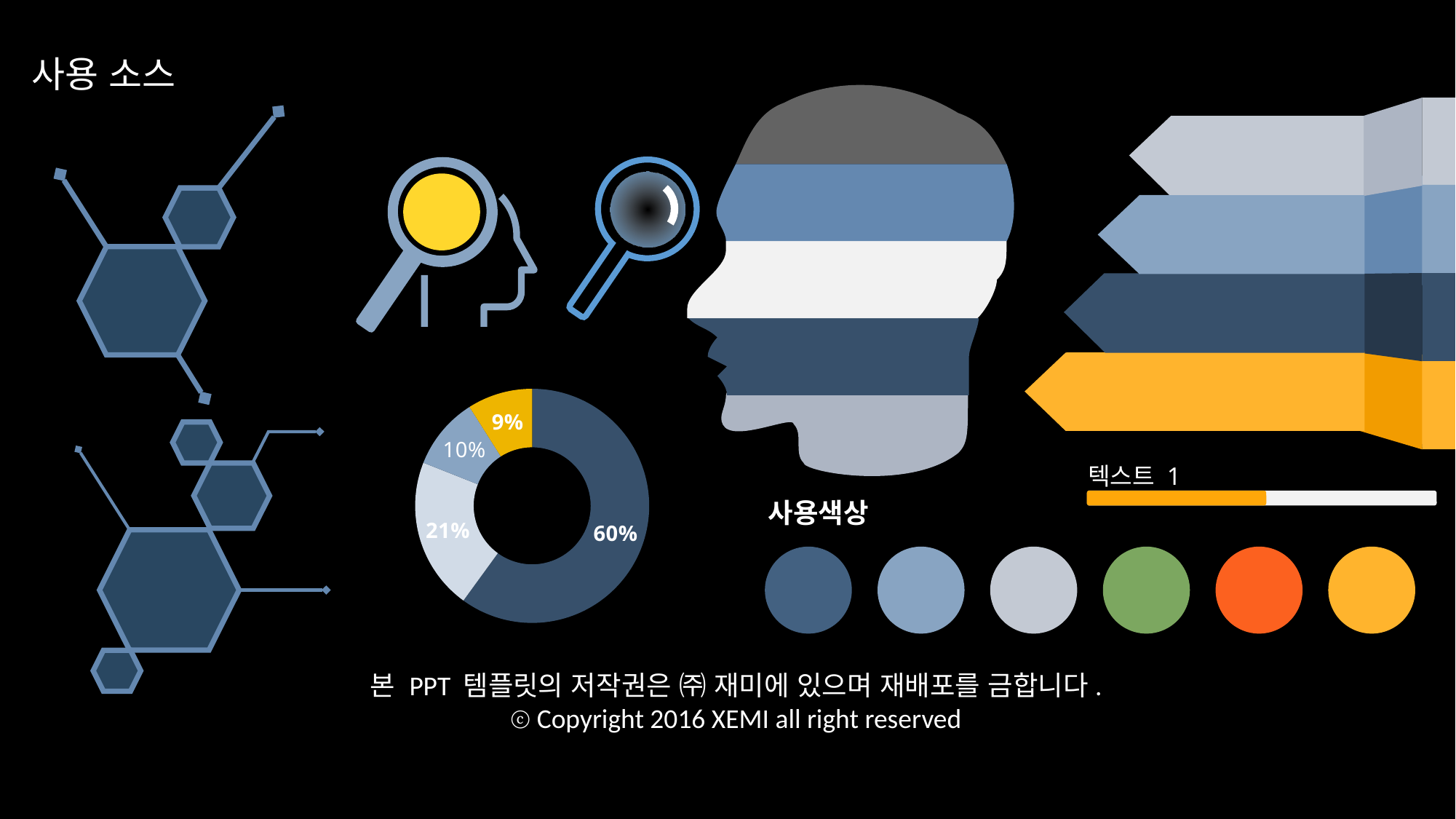
Which is larger in the doughnut chart, the light grey slice or the yellow slice? the light grey slice What colour is the largest slice of the doughnut chart? dark blue What value is shown on the dark blue slice of the doughnut chart? 60% What is the largest value shown in the doughnut chart? 60% What value is shown on the yellow slice of the doughnut chart? 9% What value is shown on the light blue slice of the doughnut chart? 10% What is the smallest value shown in the doughnut chart? 9% What is the difference between the largest and smallest slices of the doughnut chart? 51% How many slices does the doughnut chart have? 4 What kind of chart is shown on the slide? doughnut chart What value is shown on the light grey slice of the doughnut chart? 21% What is the difference between the 21% slice and the 10% slice in the doughnut chart? 11%